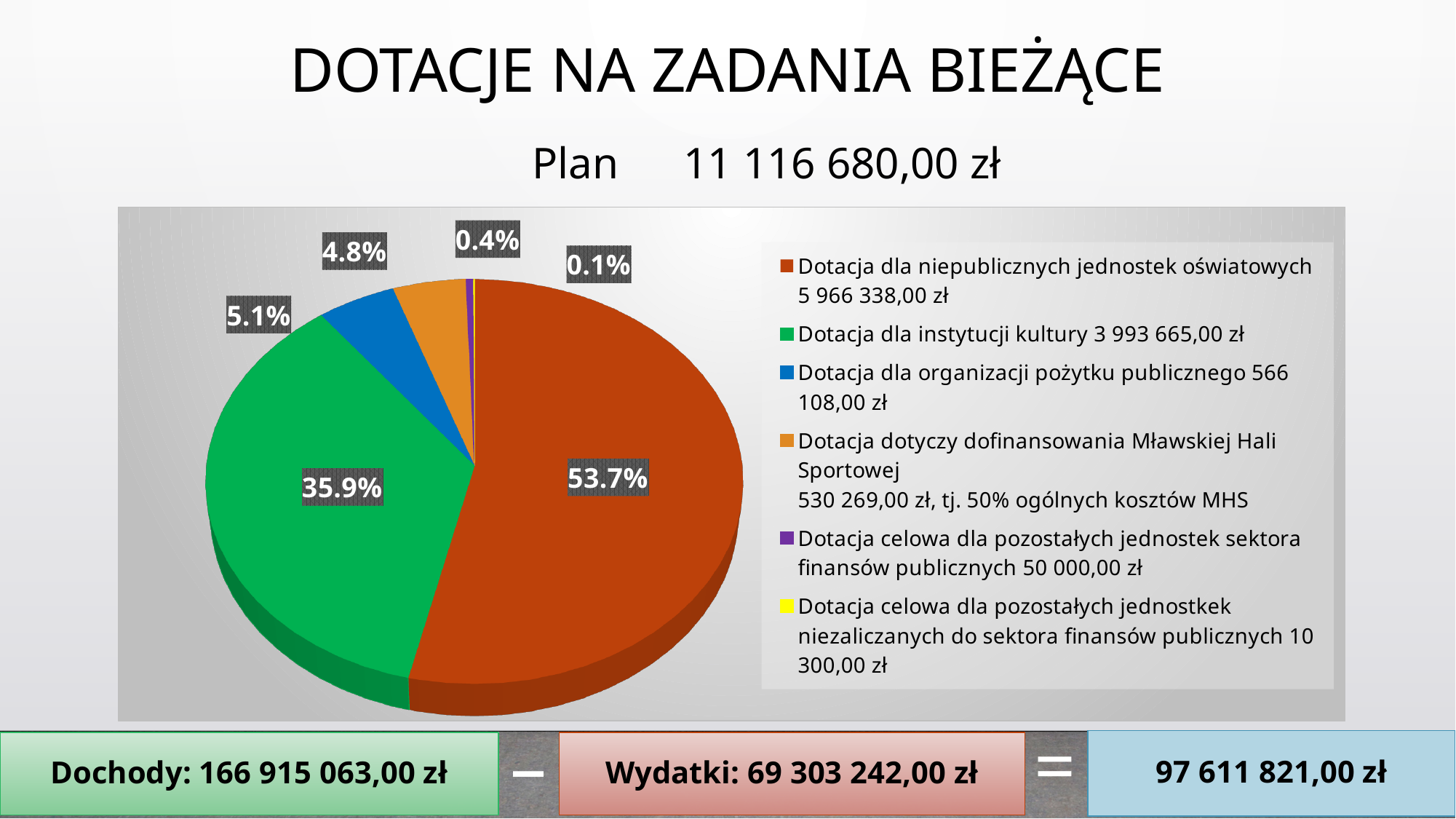
Which category has the largest slice of the pie? Dotacja dla niepublicznych jednostek oświatowych What share of the pie does 'Dotacja dla organizacji pożytku publicznego' represent? 5.1% How many slices does the pie chart have? 6 What share of the pie does 'Dotacja dotyczy dofinansowania Mławskiej Hali Sportowej' represent? 4.8% What amount does the legend give for 'Dotacja dla instytucji kultury'? 3 993 665,00 zł Which is larger: the slice for 'Dotacja dla organizacji pożytku publicznego' or the slice for 'Dotacja dotyczy dofinansowania Mławskiej Hali Sportowej'? Dotacja dla organizacji pożytku publicznego What kind of chart is shown on the slide? pie chart What share of the pie does 'Dotacja dla instytucji kultury' represent? 35.9% Which category has the smallest slice of the pie? Dotacja celowa dla pozostałych jednostkek niezaliczanych do sektora finansów publicznych What colour is the slice for 'Dotacja dla instytucji kultury'? green What is the difference in percentage points between the 'Dotacja dla niepublicznych jednostek oświatowych' slice and the 'Dotacja dla instytucji kultury' slice? 17.8